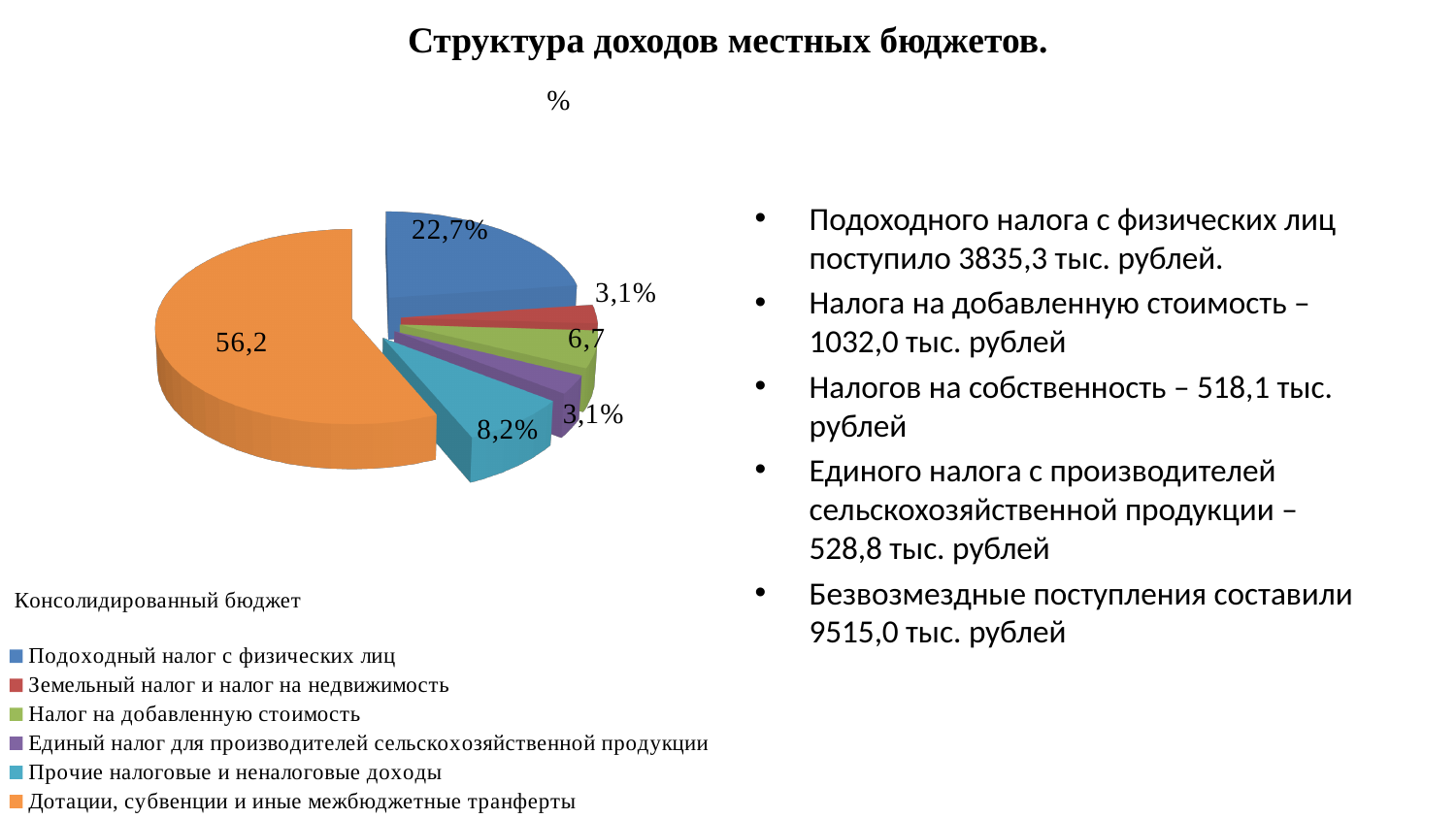
What value is shown for Прочие налоговые и неналоговые доходы? 8,2% What kind of chart is shown on the slide? Pie chart Which is larger: the slice for Подоходный налог с физических лиц or the slice for Прочие налоговые и неналоговые доходы? Подоходный налог с физических лиц How many categories does the legend of the pie chart list? 6 What value is shown for Дотации, субвенции и иные межбюджетные трансферты? 56,2 What value is shown for Налог на добавленную стоимость? 6,7 What share of the pie is labelled for Подоходный налог с физических лиц? 22,7% What share is labelled for Земельный налог и налог на недвижимость? 3,1% What colour is the slice for Дотации, субвенции и иные межбюджетные трансферты? Orange Which category has the largest slice of the pie? Дотации, субвенции и иные межбюджетные трансферты What is the title of the slide above the chart? Структура доходов местных бюджетов. What is the difference between the value for Дотации, субвенции и иные межбюджетные трансферты and the value for Подоходный налог с физических лиц? 33,5